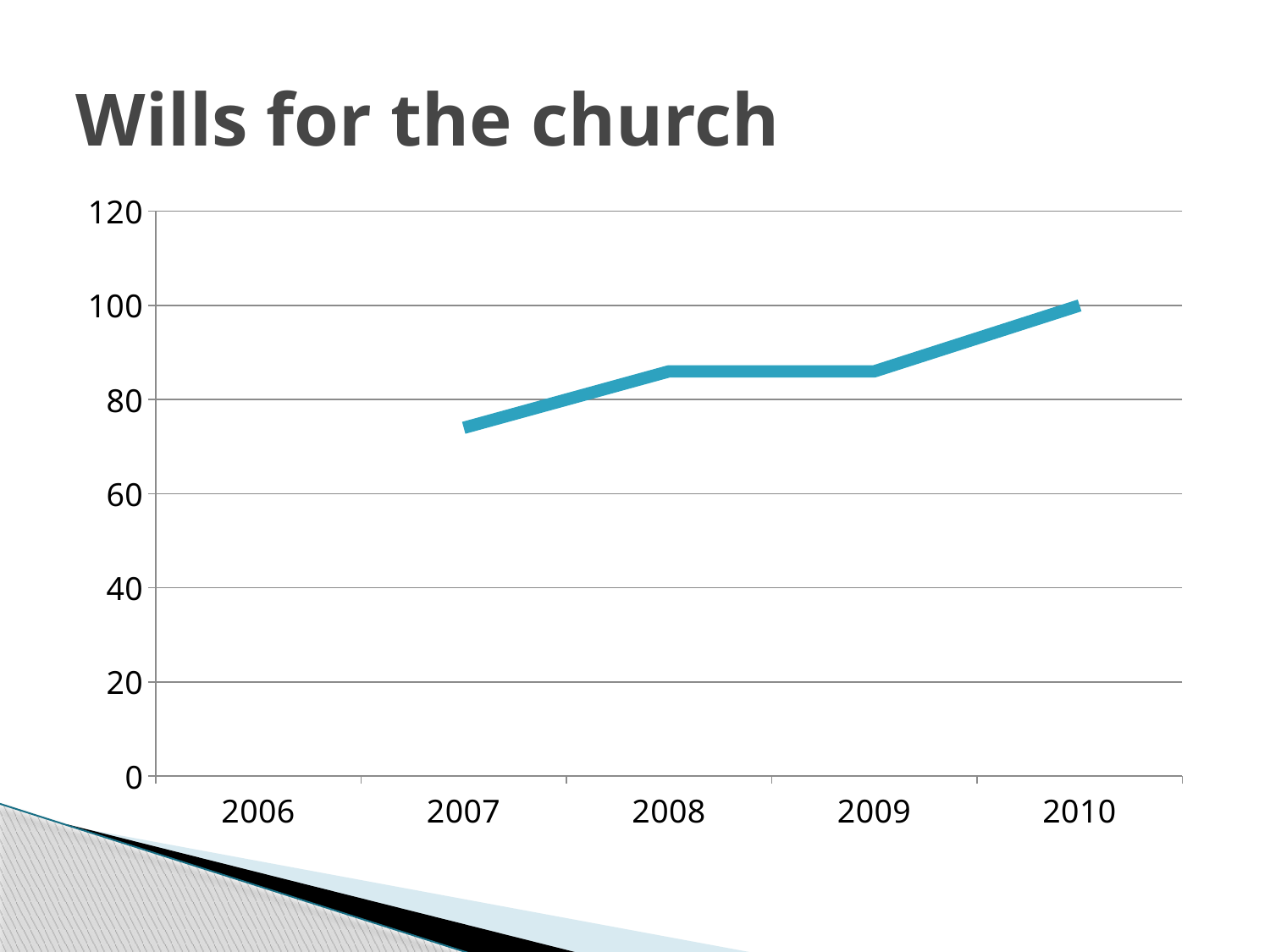
What is the title of the chart? Wills for the church Do the values generally rise or fall from 2007 to 2010? rise Is the value for 2010 greater or less than 80? greater How many years are labelled on the x axis? 5 What kind of chart is shown on the slide? line chart Is the value for 2007 greater or less than 80? less Which year has the highest value on the line? 2010 Is the value for 2007 greater or less than 60? greater Which year has the lowest plotted value on the line? 2007 Which is larger, the value for 2010 or the value for 2007? 2010